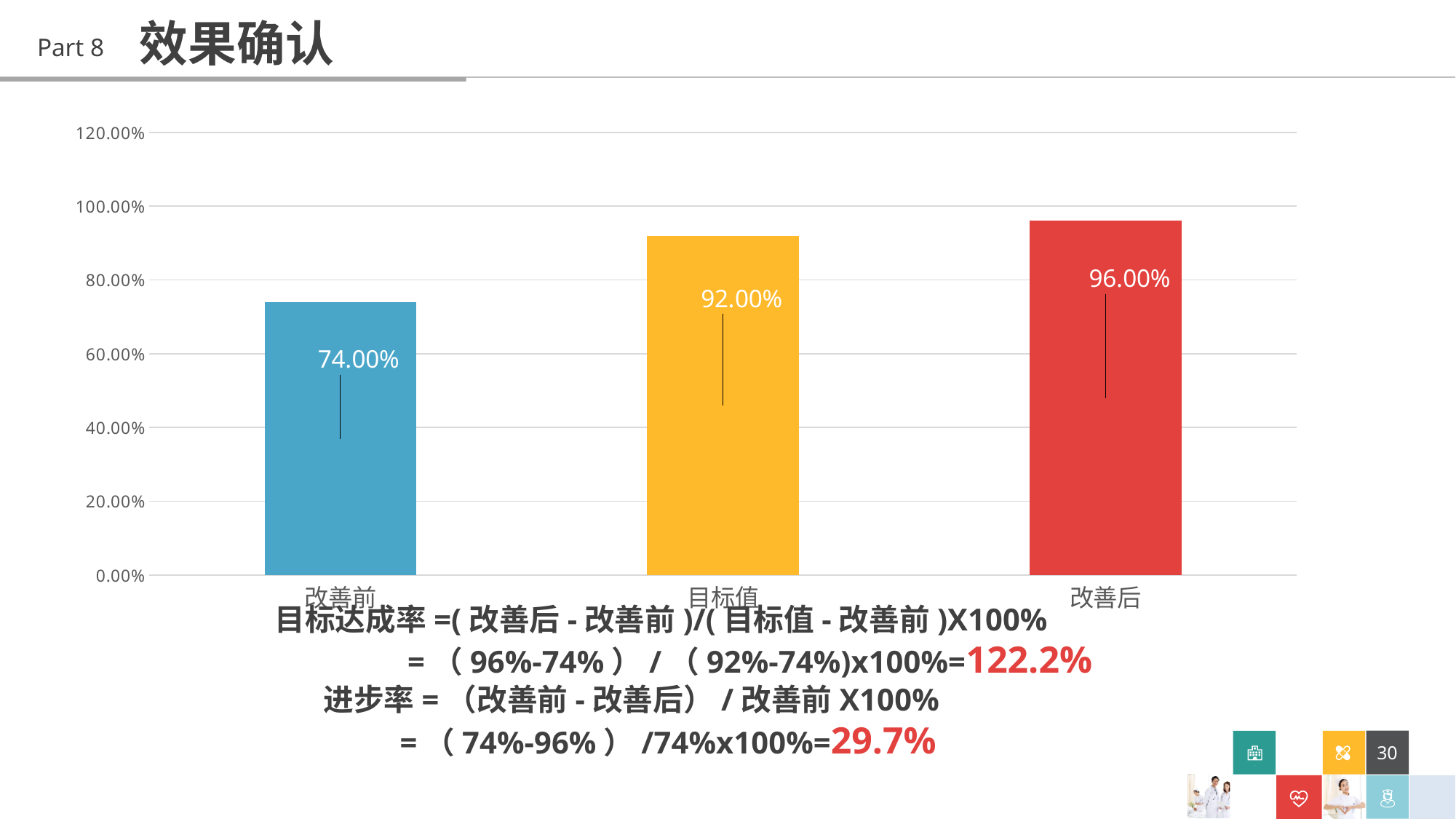
What is the difference between the values for 目标值 and 改善前? 18.00% Which category has the lowest value? 改善前 What is the value for 改善后? 96.00% What is the value for 目标值? 92.00% What is the value for 改善前? 74.00% What is the difference between the values for 改善后 and 改善前? 22.00% Which is larger, the value for 改善后 or the value for 目标值? 改善后 How many categories are shown in the chart? 3 Which category has the highest value? 改善后 Is the value for 改善前 greater or less than 80.00%? less What colour is the bar for 目标值? yellow What kind of chart is shown on the slide? bar chart